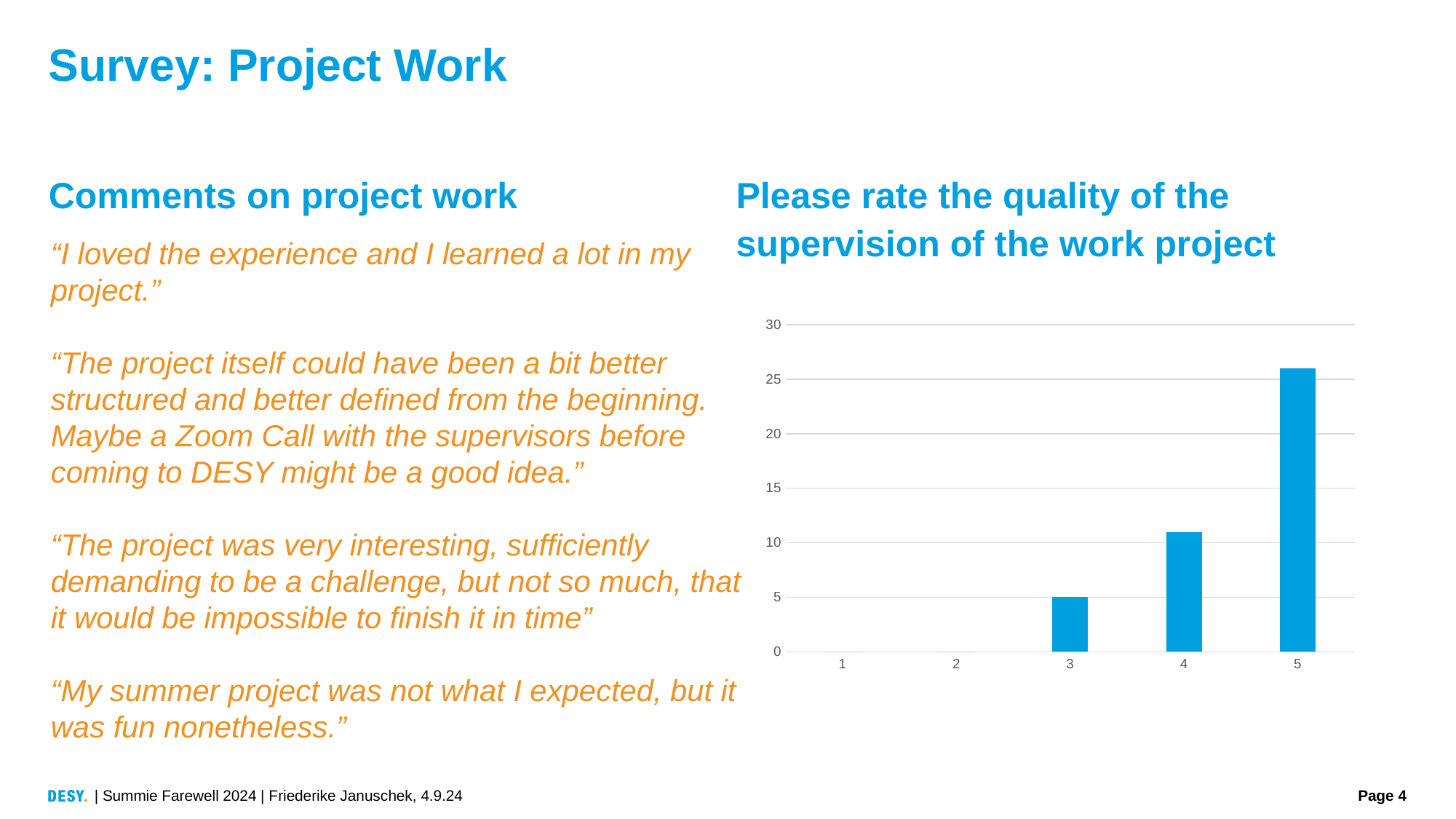
How many rating categories are shown on the x axis of the chart? 5 Which has more responses, rating 4 or rating 5? 5 Which rating received the highest number of responses? 5 What is the title of the chart? Please rate the quality of the supervision of the work project Is the value for rating 5 greater or less than 20? greater Is the value for rating 4 greater or less than 5? greater Is the value for rating 4 greater or less than 15? less Do the values rise or fall from rating 3 to rating 5? rise How many responses did rating 3 receive? 5 Which has more responses, rating 3 or rating 4? 4 What kind of chart is shown on the slide? bar chart